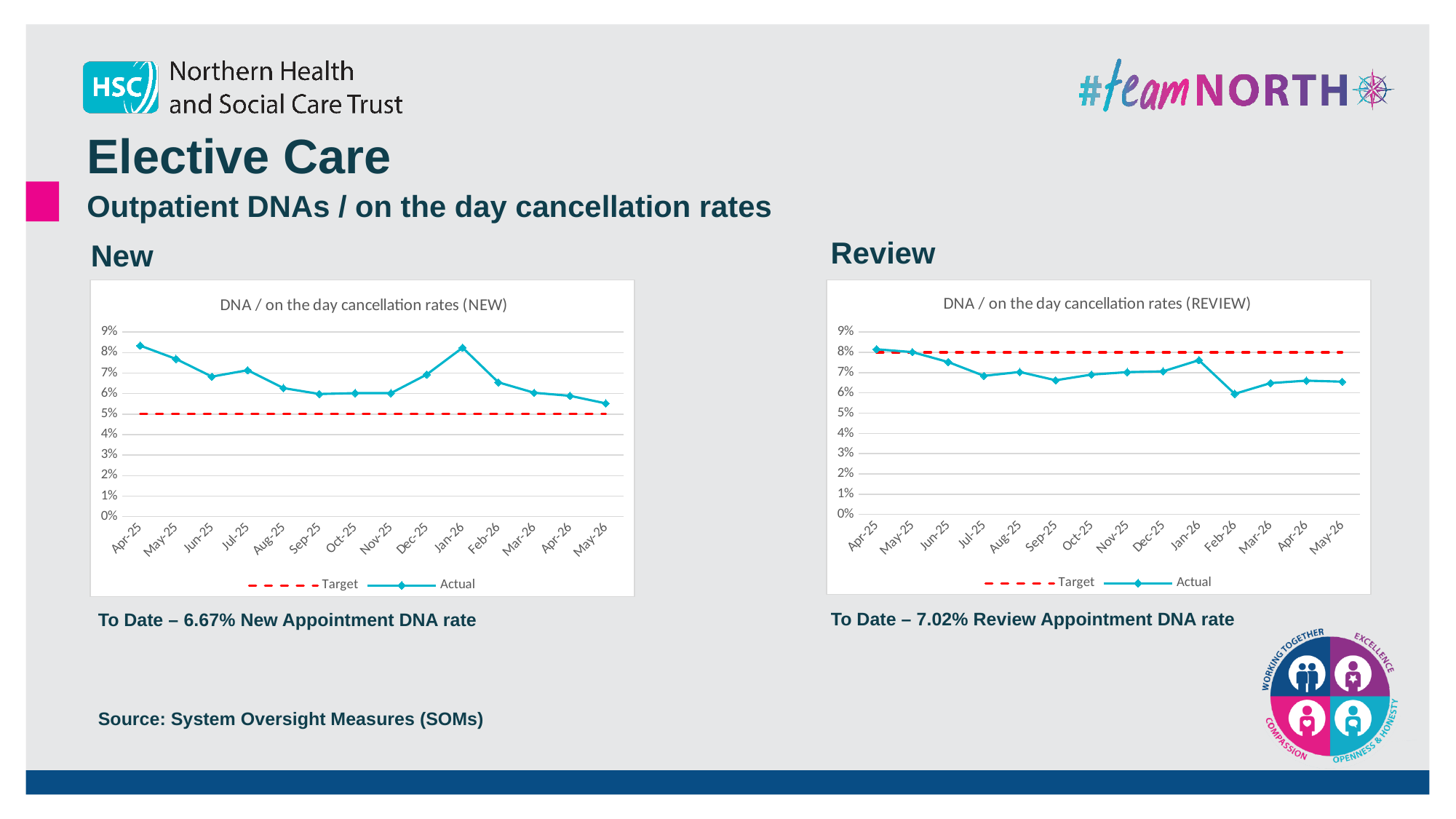
On the 'DNA / on the day cancellation rates (NEW)' chart, which month has the lowest Actual value? May-26 On the 'DNA / on the day cancellation rates (REVIEW)' chart, which month has the lowest Actual value? Feb-26 How many months are plotted along the x axis of the 'DNA / on the day cancellation rates (NEW)' chart? 14 How many series does the legend list on the 'DNA / on the day cancellation rates (REVIEW)' chart? 2 On the 'DNA / on the day cancellation rates (NEW)' chart, is the Actual value for Apr-25 greater or less than 8%? greater On the 'DNA / on the day cancellation rates (NEW)' chart, what value does the Target line sit at? 5% On the 'DNA / on the day cancellation rates (NEW)' chart, does the Actual line overall rise or fall from Apr-25 to May-26? fall On the 'DNA / on the day cancellation rates (REVIEW)' chart, what value does the Target line sit at? 8% What kind of chart is the 'DNA / on the day cancellation rates (NEW)' chart? line chart On the 'DNA / on the day cancellation rates (NEW)' chart, which is larger, the Actual value for Apr-25 or for May-26? Apr-25 On the 'DNA / on the day cancellation rates (REVIEW)' chart, is the Actual value for Jan-26 greater or less than 8%? less What are the two legend entries on the 'DNA / on the day cancellation rates (NEW)' chart? Target and Actual